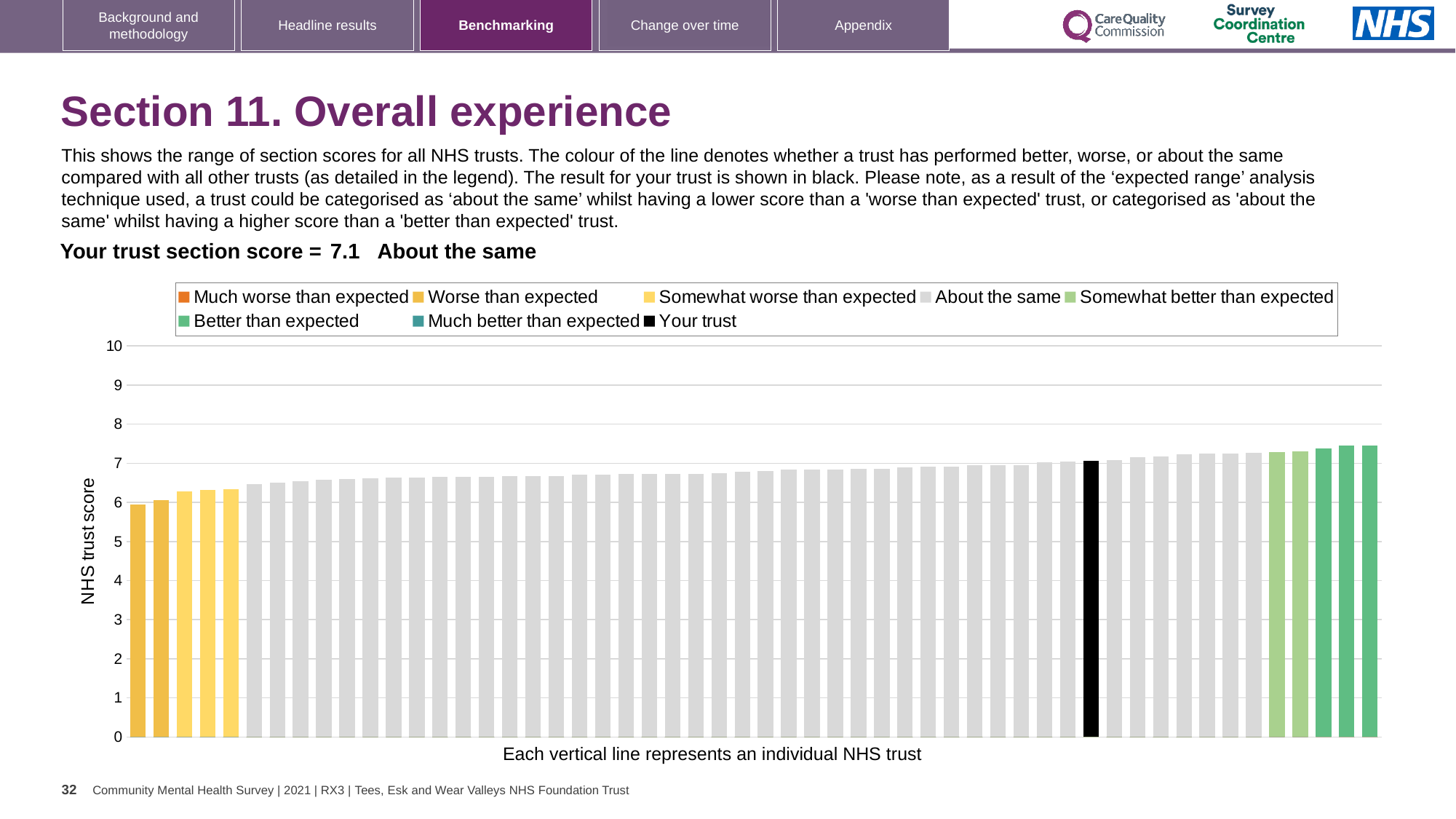
Is the value of the rightmost bar greater or less than 8? less Is the value of the leftmost bar greater or less than 7? less How many entries does the chart legend list? 8 Is the value of the black 'Your trust' bar greater or less than 5? greater Which is larger, the leftmost bar or the black 'Your trust' bar? Your trust What is the label on the vertical axis of the chart? NHS trust score Which category is your trust placed in for this section? About the same What kind of chart is shown on the slide? bar chart Do the bar values rise or fall from left to right along the x axis? rise What colour is the bar representing your trust? black What is the section score for your trust shown on the slide? 7.1